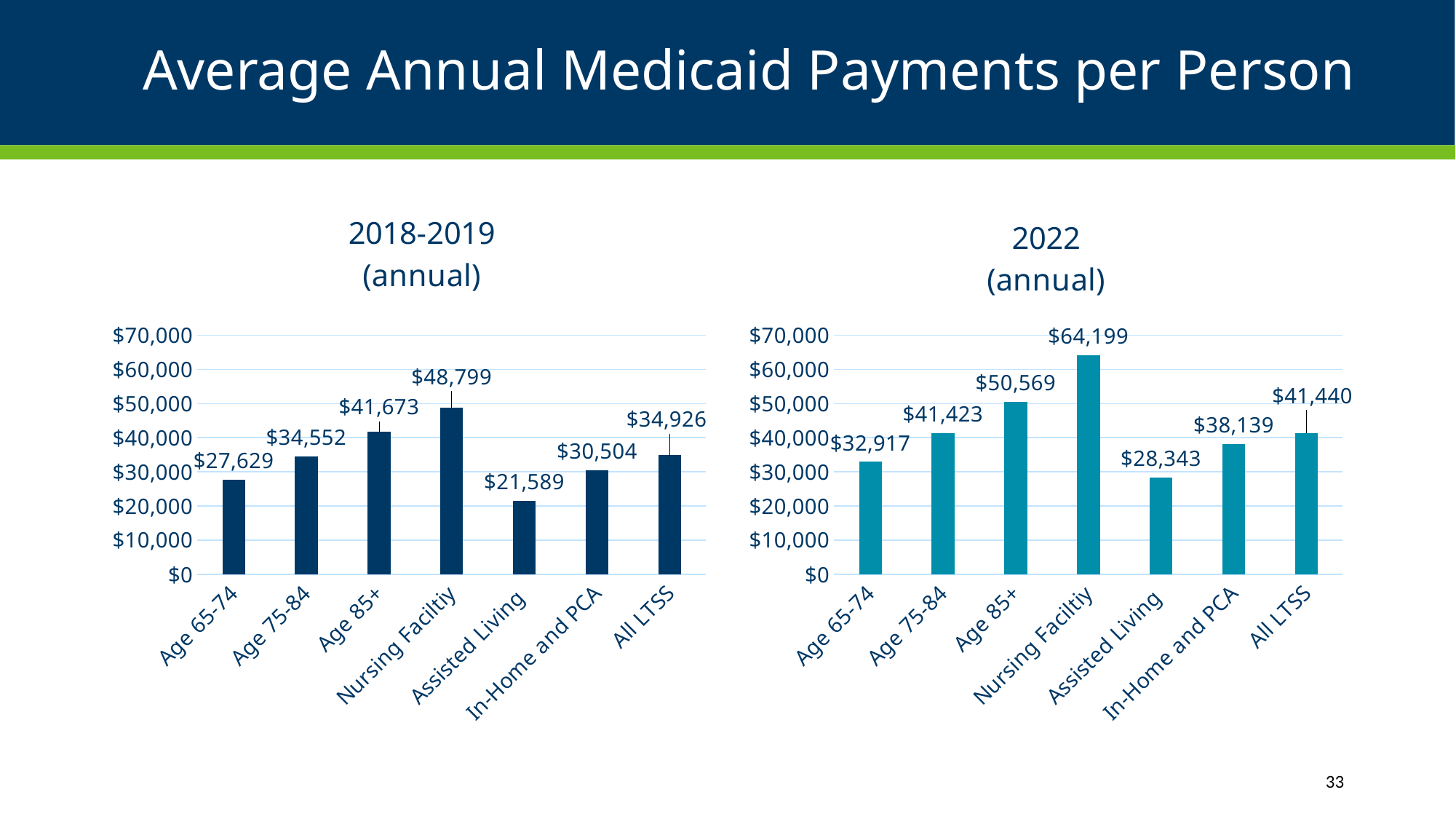
In the 2018-2019 (annual) chart, what is the difference between Age 85+ and Age 65-74? $14,044 What kind of chart is the 2018-2019 (annual) chart? bar chart In the 2018-2019 (annual) chart, what is the value for Nursing Facility? $48,799 Which is larger: the Age 75-84 value in the 2018-2019 (annual) chart or the Age 75-84 value in the 2022 (annual) chart? 2022 (annual) In the 2022 (annual) chart, what is the difference between Nursing Facility and In-Home and PCA? $26,060 In the 2018-2019 (annual) chart, which category has the highest value? Nursing Facility How many categories are shown in the 2022 (annual) chart? 7 In the 2022 (annual) chart, what is the value for Assisted Living? $28,343 In the 2022 (annual) chart, what is the value for All LTSS? $41,440 In the 2022 (annual) chart, which category has the lowest value? Assisted Living In the 2018-2019 (annual) chart, is the value for In-Home and PCA greater or less than $40,000? less What is the title of the slide? Average Annual Medicaid Payments per Person